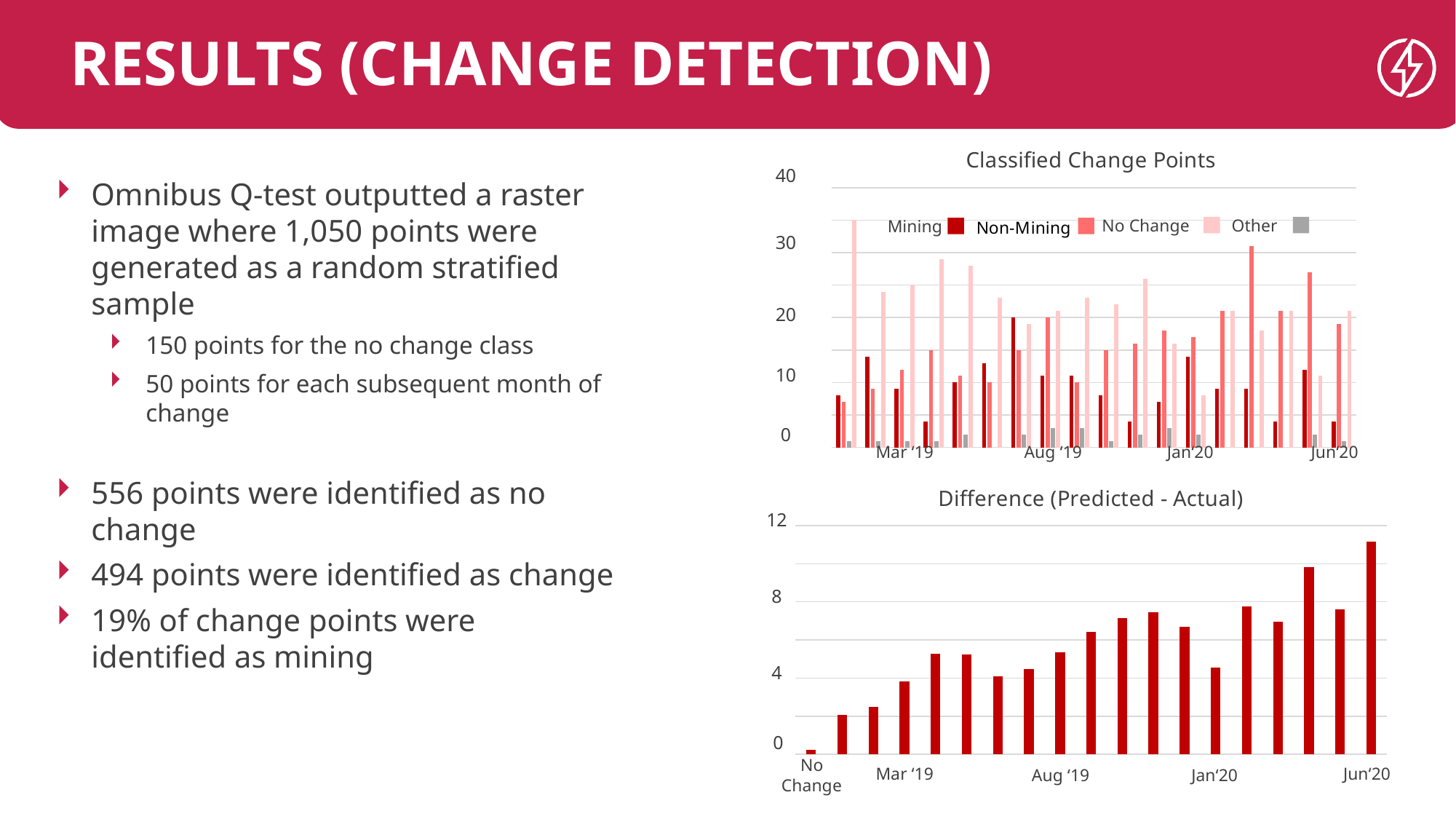
In the "Classified Change Points" chart, is the Mining value at Jun'20 greater or less than 10? less In the "Difference (Predicted - Actual)" chart, is the value for Jun'20 greater or less than 8? greater In the "Difference (Predicted - Actual)" chart, which category has the lowest value? No Change In the "Difference (Predicted - Actual)" chart, which is larger, the value for Jun'20 or the value for Jan'20? Jun'20 How many series does the legend of the "Classified Change Points" chart list? 4 What kind of chart is the "Difference (Predicted - Actual)" chart? bar chart In the "Classified Change Points" chart, which series is shown in grey? Other In the "Difference (Predicted - Actual)" chart, do the values generally rise or fall from No Change to Jun'20? rise In the "Classified Change Points" chart, at Mar '19, which is larger, the Other bar or the Mining bar? Mining In the "Difference (Predicted - Actual)" chart, which category has the highest value? Jun'20 What kind of chart is the "Classified Change Points" chart? bar chart